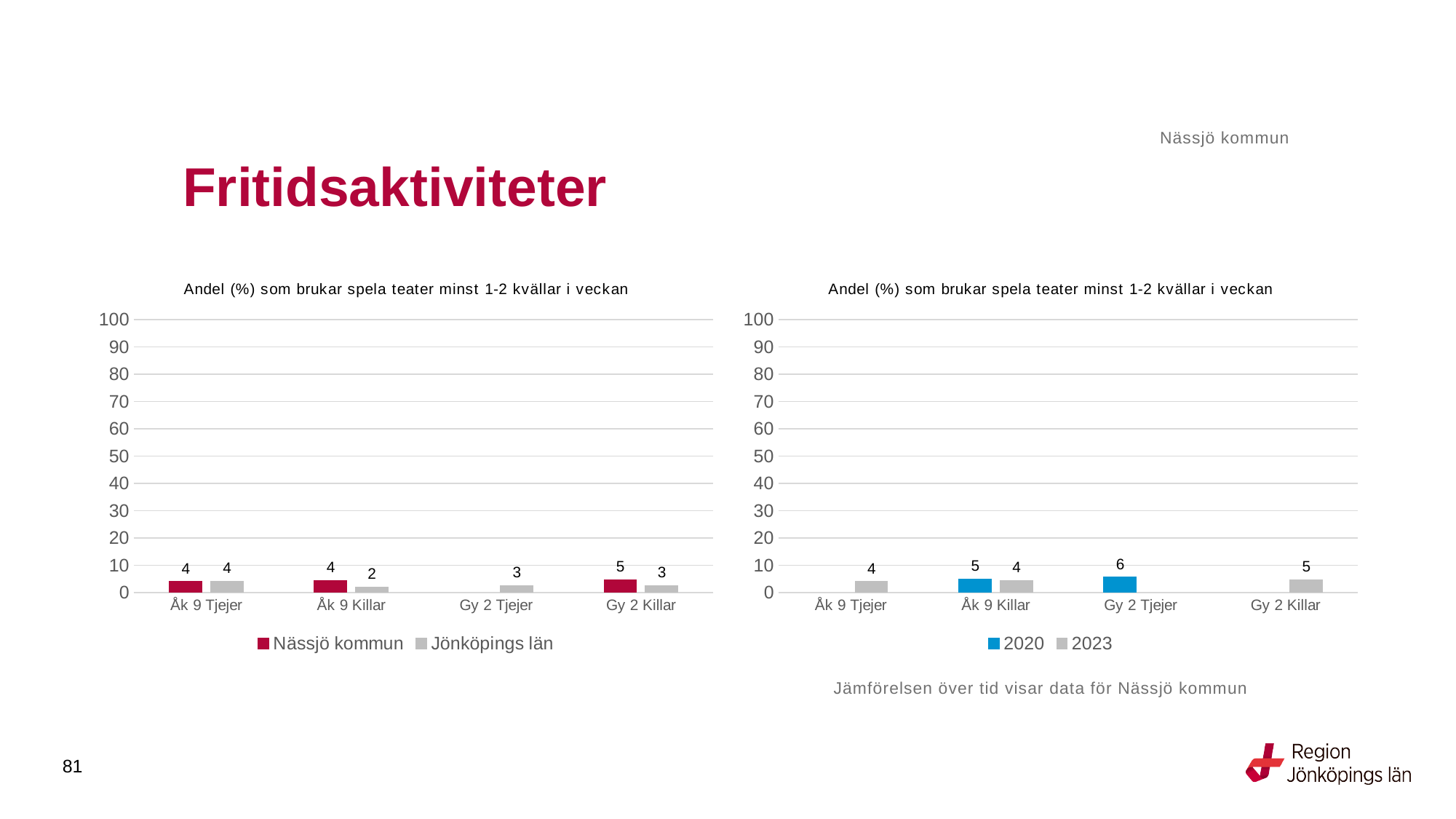
In the left chart, how many series does the legend list? 2 In the right chart, what is the value for 2020 for Gy 2 Tjejer? 6 In the right chart, is the value for 2020 for Gy 2 Tjejer greater or less than 10? less In the right chart, what is the difference between 2020 and 2023 for Åk 9 Killar? 1 In the left chart, what is the value for Jönköpings län for Åk 9 Killar? 2 In the left chart, what is the value for Jönköpings län for Gy 2 Tjejer? 3 How many categories are shown on the x axis of the right chart? 4 What kind of chart is the left chart? Bar chart In the right chart, what is the value for 2023 for Gy 2 Killar? 5 In the left chart, what is the difference between Nässjö kommun and Jönköpings län for Åk 9 Killar? 2 In the left chart, which is larger for Gy 2 Killar: Nässjö kommun or Jönköpings län? Nässjö kommun In the left chart, what is the value for Nässjö kommun for Gy 2 Killar? 5